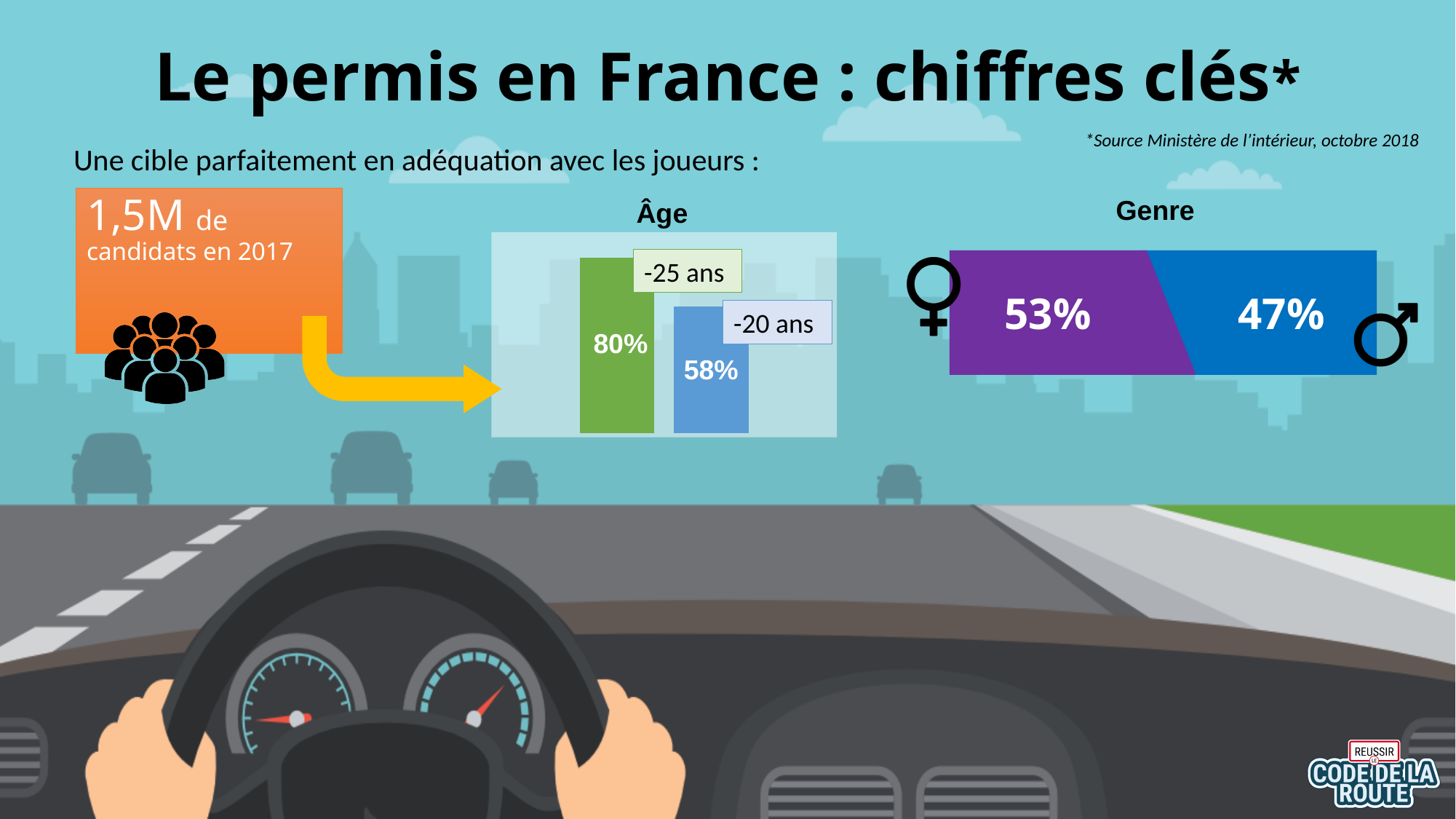
In the "Âge" chart, what is the difference between the values for -25 ans and -20 ans? 22% What kind of chart is the "Âge" chart? Bar chart In the "Âge" chart, what is the value for -20 ans? 58% In the "Genre" chart, which group has the larger share, women or men? Women In the "Âge" chart, what is the value for -25 ans? 80% In the "Âge" chart, which is larger: the value for -25 ans or the value for -20 ans? -25 ans In the "Genre" chart, what is the share for women (female symbol)? 53% How many bars are shown in the "Âge" chart? 2 In the "Âge" chart, which category has the lowest value? -20 ans In the "Âge" chart, which category has the highest value? -25 ans In the "Âge" chart, what colour is the bar for -25 ans? Green In the "Genre" chart, what is the share for men (male symbol)? 47%